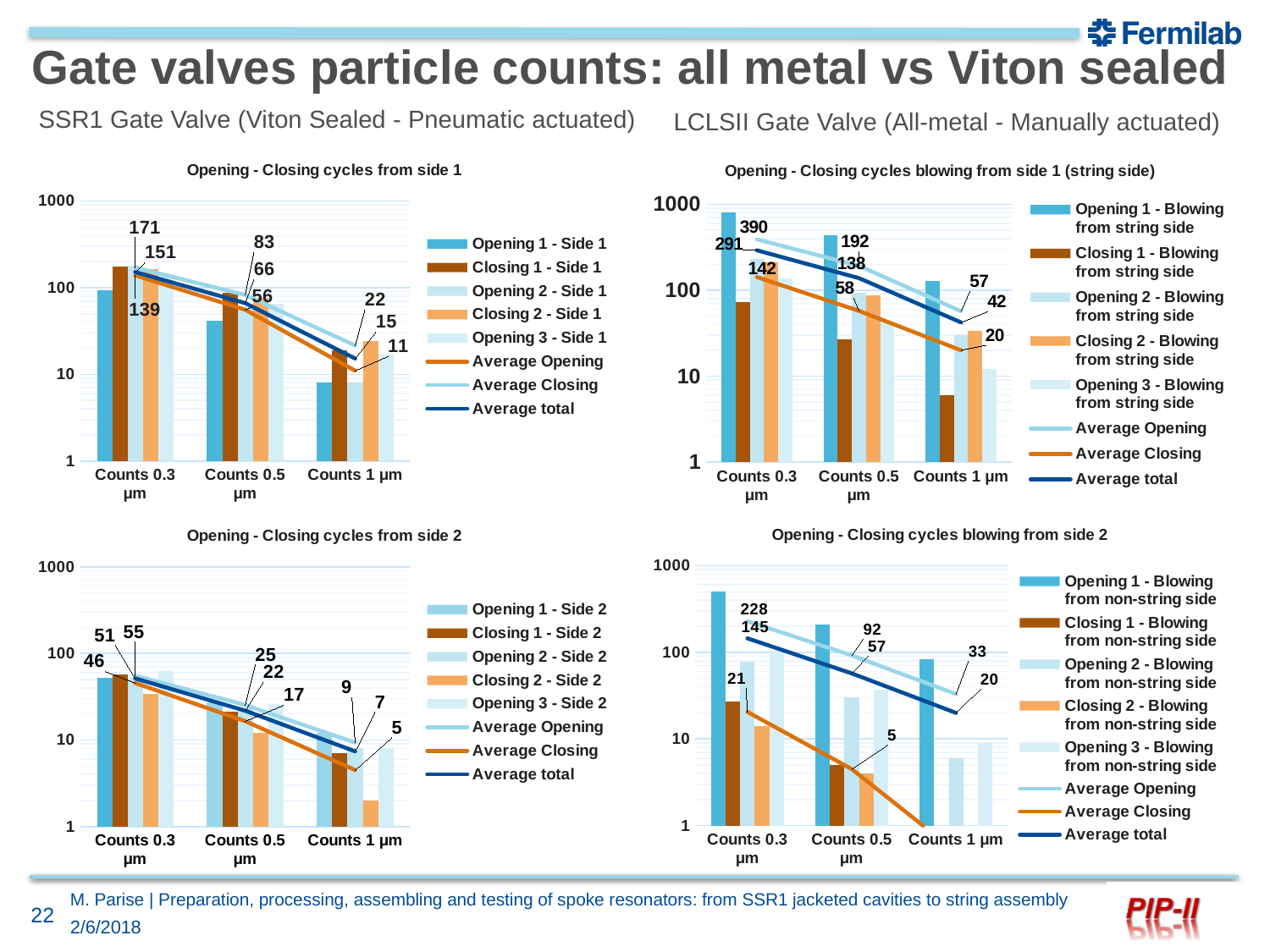
What is the title of the chart in the bottom-right of the slide? Opening - Closing cycles blowing from side 2 How many charts are shown on the slide? 4 What kind of chart is 'Opening - Closing cycles from side 2'? Bar chart with line series In the chart titled 'Opening - Closing cycles blowing from side 2', what is the largest data label shown at Counts 0.3 µm? 228 In the chart titled 'Opening - Closing cycles from side 2', is the Closing 2 bar at Counts 1 µm greater or less than 10? less In the chart titled 'Opening - Closing cycles from side 1', what is the largest data label shown at Counts 1 µm? 22 In the chart titled 'Opening - Closing cycles blowing from side 1 (string side)', is the Opening 1 bar at Counts 0.3 µm greater or less than 100? greater In the chart titled 'Opening - Closing cycles from side 1', how many entries does the legend list? 8 In the chart titled 'Opening - Closing cycles blowing from side 1 (string side)', do the Average total values rise or fall from Counts 0.3 µm to Counts 1 µm? Fall In the chart titled 'Opening - Closing cycles blowing from side 1 (string side)', how many categories are shown on the x axis? 3 In the chart titled 'Opening - Closing cycles blowing from side 1 (string side)', at which category is the Opening 1 bar highest? Counts 0.3 µm In the chart titled 'Opening - Closing cycles blowing from side 1 (string side)', which is larger at Counts 0.3 µm: the Opening 1 bar or the Closing 1 bar? Opening 1